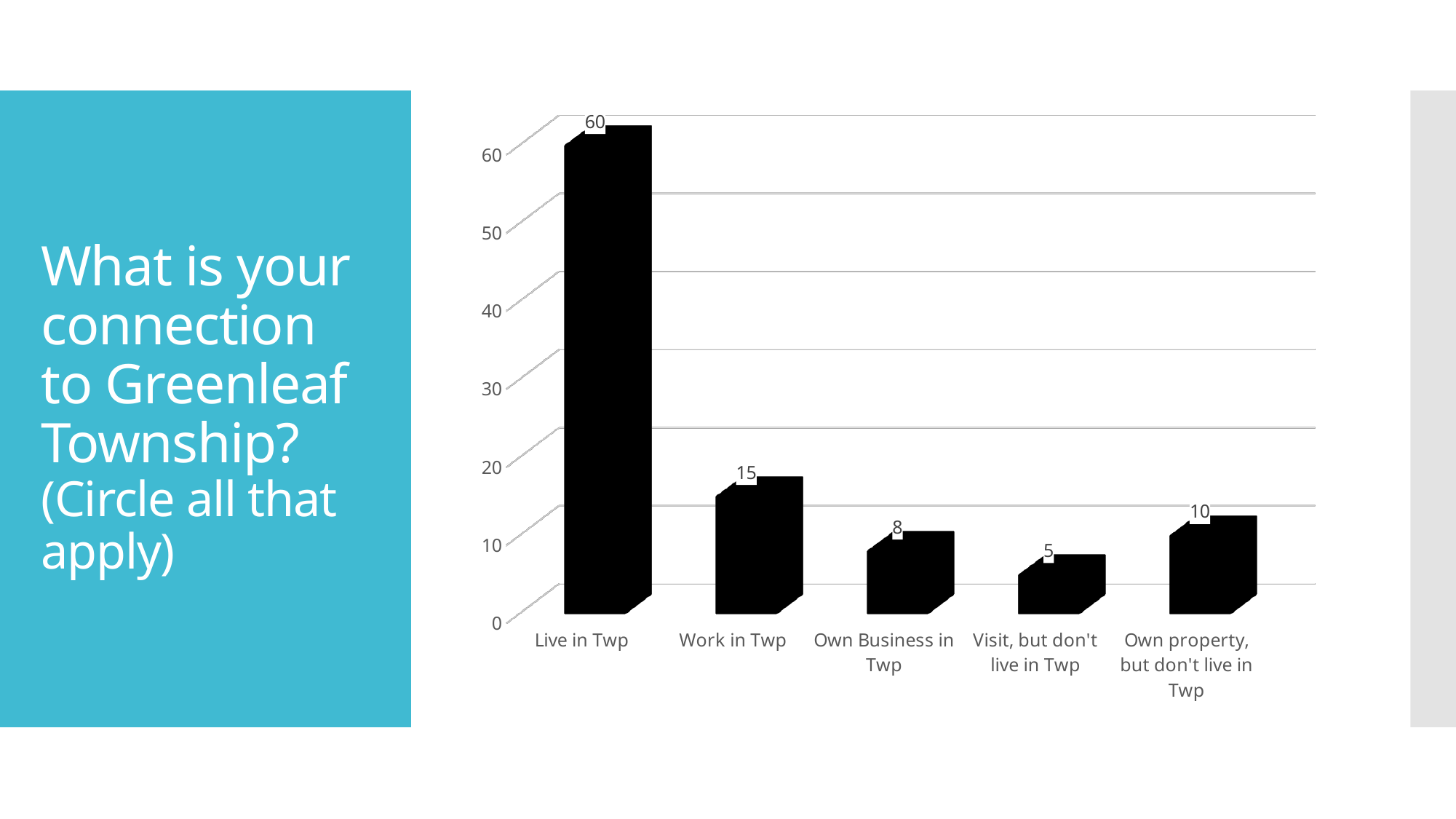
What is the value for Own property, but don't live in Twp? 10 What is the value for Work in Twp? 15 What is the value for Live in Twp? 60 What is the difference between the values for Live in Twp and Work in Twp? 45 Which category has the highest value? Live in Twp What is the title text on the left of the slide? What is your connection to Greenleaf Township? (Circle all that apply) What is the value for Own Business in Twp? 8 Which is larger, the value for Own Business in Twp or the value for Own property, but don't live in Twp? Own property, but don't live in Twp What is the value for Visit, but don't live in Twp? 5 What kind of chart is shown on the slide? Bar chart How many categories are shown on the chart? 5 Which category has the lowest value? Visit, but don't live in Twp